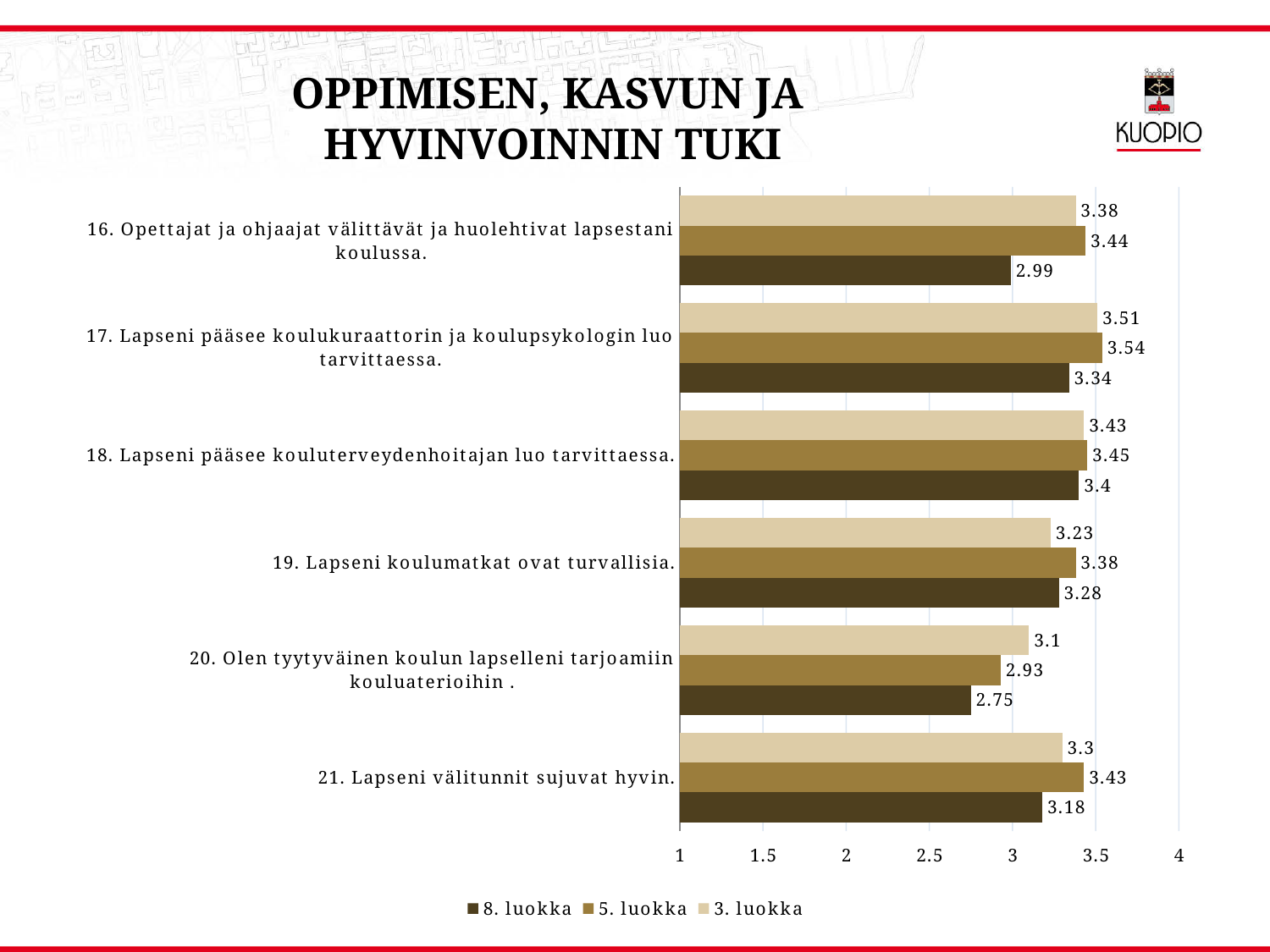
How many series does the legend list? 3 What kind of chart is shown on the slide? bar chart Which statement has the highest value for 5. luokka? 17. Lapseni pääsee koulukuraattorin ja koulupsykologin luo tarvittaessa. Which statement has the lowest value for 8. luokka? 20. Olen tyytyväinen koulun lapselleni tarjoamiin kouluaterioihin. What is the value for 5. luokka for statement 17 (Lapseni pääsee koulukuraattorin ja koulupsykologin luo tarvittaessa)? 3.54 How many statements (categories) are plotted on the chart? 6 Which series is shown with the darkest brown colour in the legend? 8. luokka For statement 21 (Lapseni välitunnit sujuvat hyvin), which is larger: the value for 5. luokka or for 8. luokka? 5. luokka What is the value for 8. luokka for statement 16 (Opettajat ja ohjaajat välittävät ja huolehtivat lapsestani koulussa)? 2.99 What is the value for 3. luokka for statement 20 (Olen tyytyväinen koulun lapselleni tarjoamiin kouluaterioihin)? 3.1 Is the value for 8. luokka for statement 20 greater or less than 3? less What is the difference between the 5. luokka and 8. luokka values for statement 16? 0.45